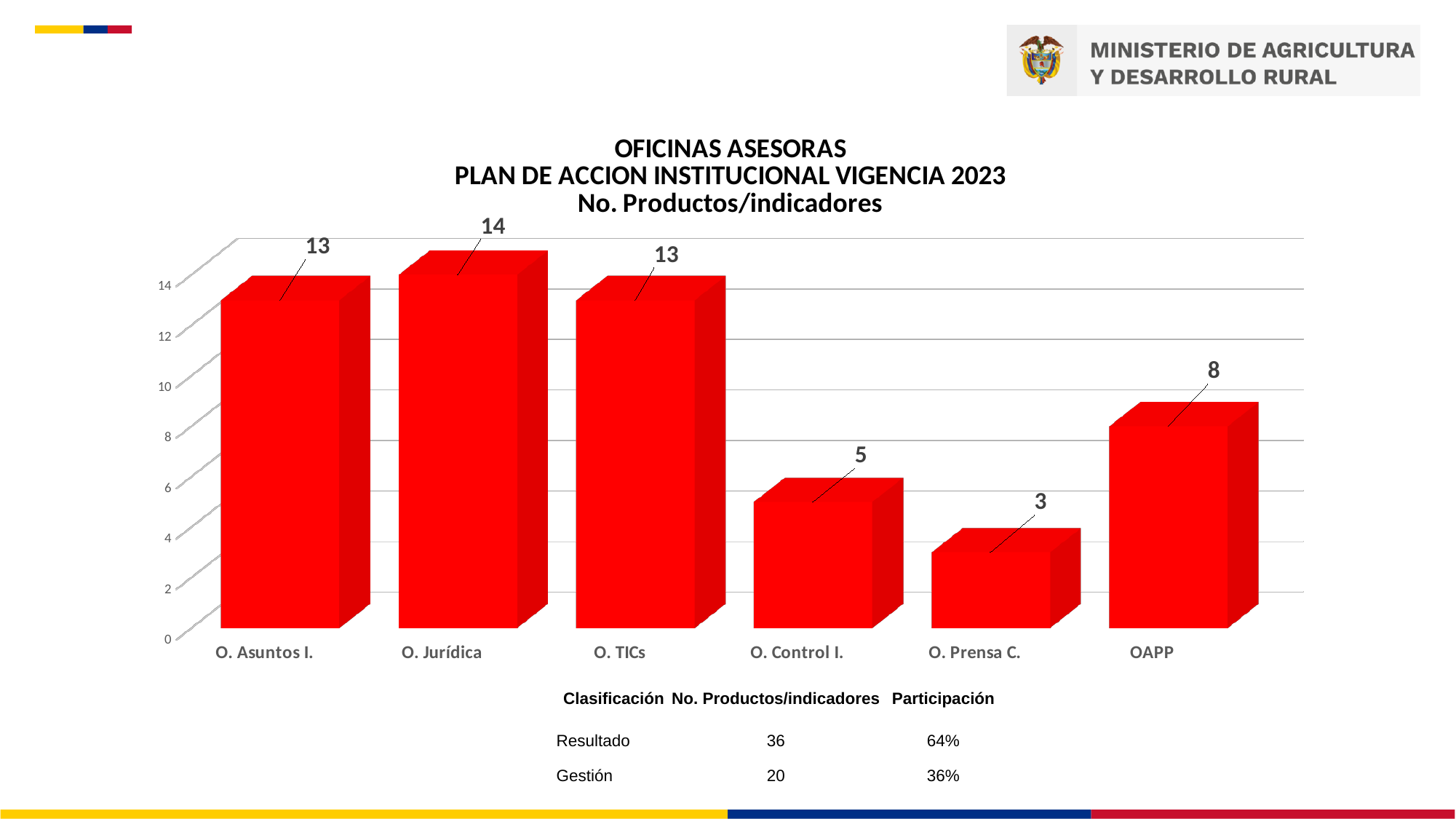
Which category has the lowest value? O. Prensa C. Which category has the highest value? O. Jurídica What is the value for O. Control I.? 5 Which is larger, the value for O. Control I. or the value for OAPP? OAPP What is the value for O. Prensa C.? 3 What colour are the bars in the chart? red How many categories are shown on the x axis? 6 What is the value for OAPP? 8 What is the value for O. Jurídica? 14 What is the difference between the values for O. Jurídica and OAPP? 6 Is the value for O. TICs greater or less than 10? greater What kind of chart is shown on the slide? bar chart